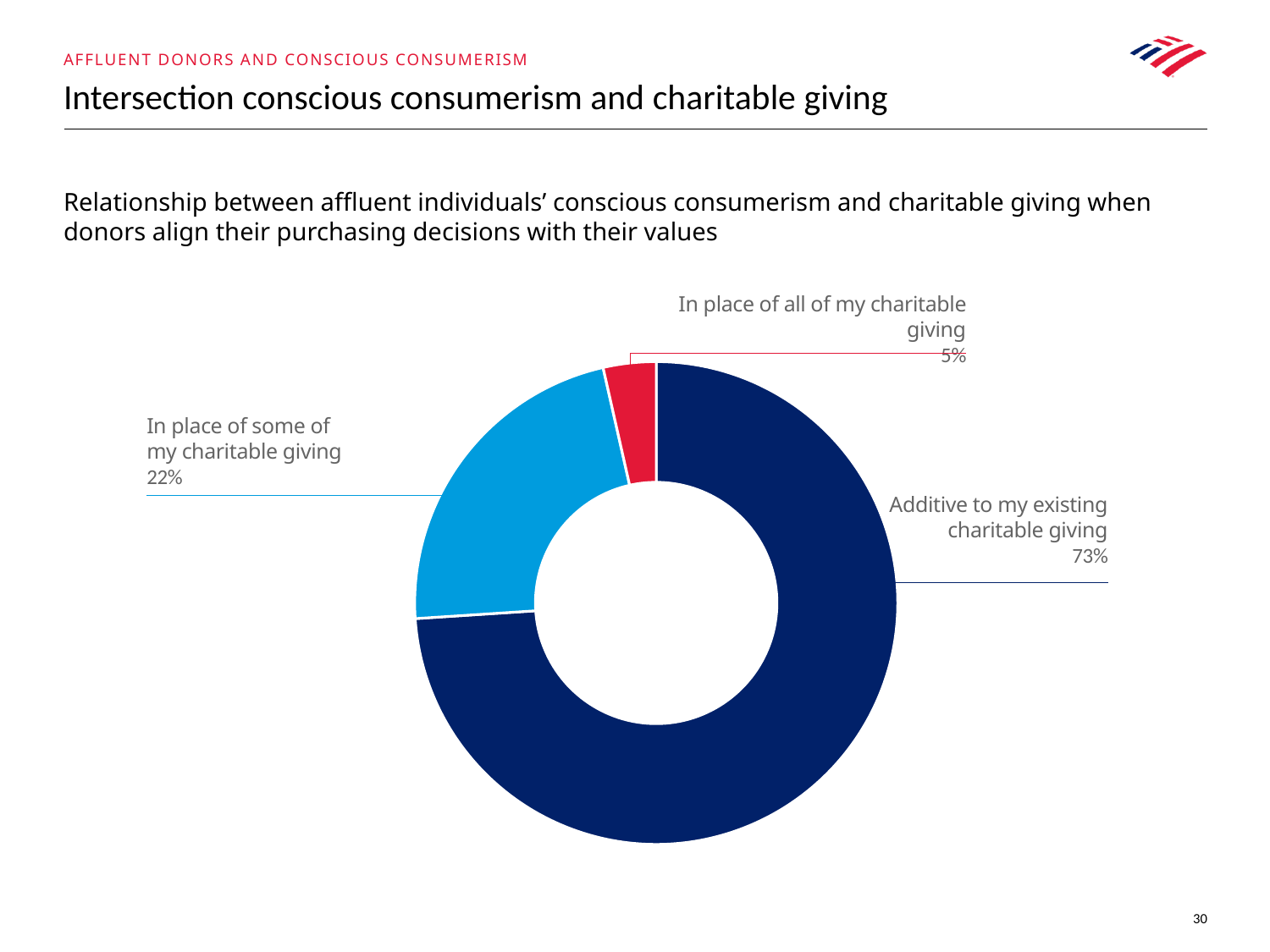
Which response has the smallest share of the chart? In place of all of my charitable giving What is the difference between the 'In place of some of my charitable giving' share and the 'In place of all of my charitable giving' share? 17 percentage points What type of chart is shown on the slide? Doughnut (pie) chart What percentage say conscious consumerism is in place of all of their charitable giving? 5% Which response has the largest share of the chart? Additive to my existing charitable giving What colour is the segment for 'In place of all of my charitable giving'? Red What percentage of affluent donors say their conscious consumerism is additive to their existing charitable giving? 73% Which is larger: the share for 'In place of some of my charitable giving' or 'In place of all of my charitable giving'? In place of some of my charitable giving What is the difference in percentage points between 'Additive to my existing charitable giving' and 'In place of some of my charitable giving'? 51 percentage points What colour is the segment for 'Additive to my existing charitable giving'? Dark blue How many categories are shown in the chart? 3 What share of respondents say conscious consumerism is in place of some of their charitable giving? 22%